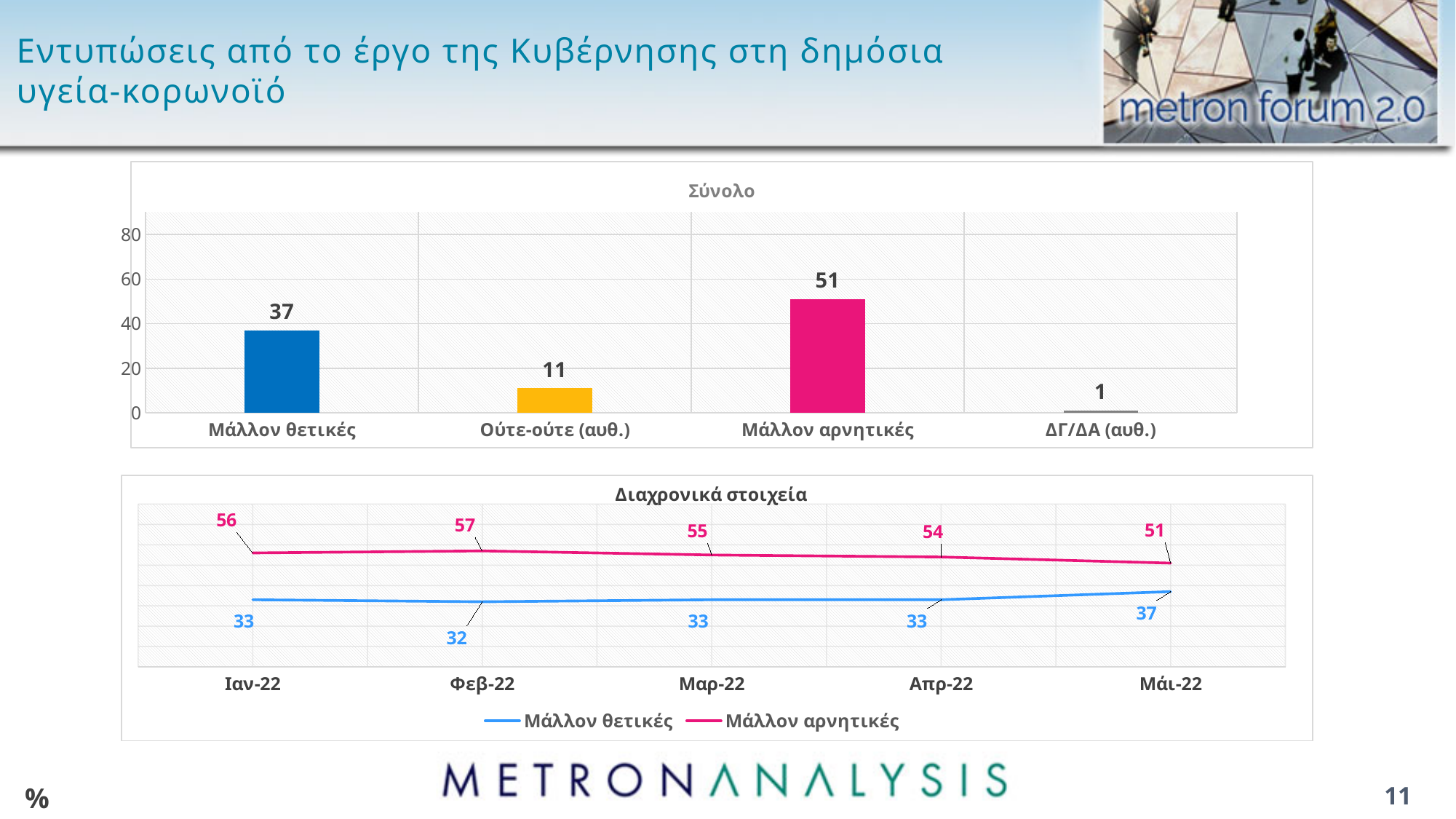
In the 'Διαχρονικά στοιχεία' chart, does 'Μάλλον αρνητικές' rise or fall from Φεβ-22 to Μάι-22? fall In the 'Διαχρονικά στοιχεία' chart, in which month is 'Μάλλον αρνητικές' highest? Φεβ-22 What kind of chart is the 'Διαχρονικά στοιχεία' chart? line chart In the 'Διαχρονικά στοιχεία' chart, what is the value for 'Μάλλον θετικές' in Μάι-22? 37 In the 'Διαχρονικά στοιχεία' chart, what is the value for 'Μάλλον αρνητικές' in Φεβ-22? 57 In the 'Σύνολο' chart, which category has the lowest value? ΔΓ/ΔΑ (αυθ.) In the 'Σύνολο' chart, what is the value for 'Μάλλον αρνητικές'? 51 In the 'Σύνολο' chart, how many categories are shown? 4 In the 'Διαχρονικά στοιχεία' chart, what is the difference between 'Μάλλον αρνητικές' and 'Μάλλον θετικές' in Ιαν-22? 23 In the 'Διαχρονικά στοιχεία' chart, how many series does the legend list? 2 What kind of chart is the 'Σύνολο' chart? bar chart In the 'Σύνολο' chart, what is the difference between 'Μάλλον αρνητικές' and 'Μάλλον θετικές'? 14